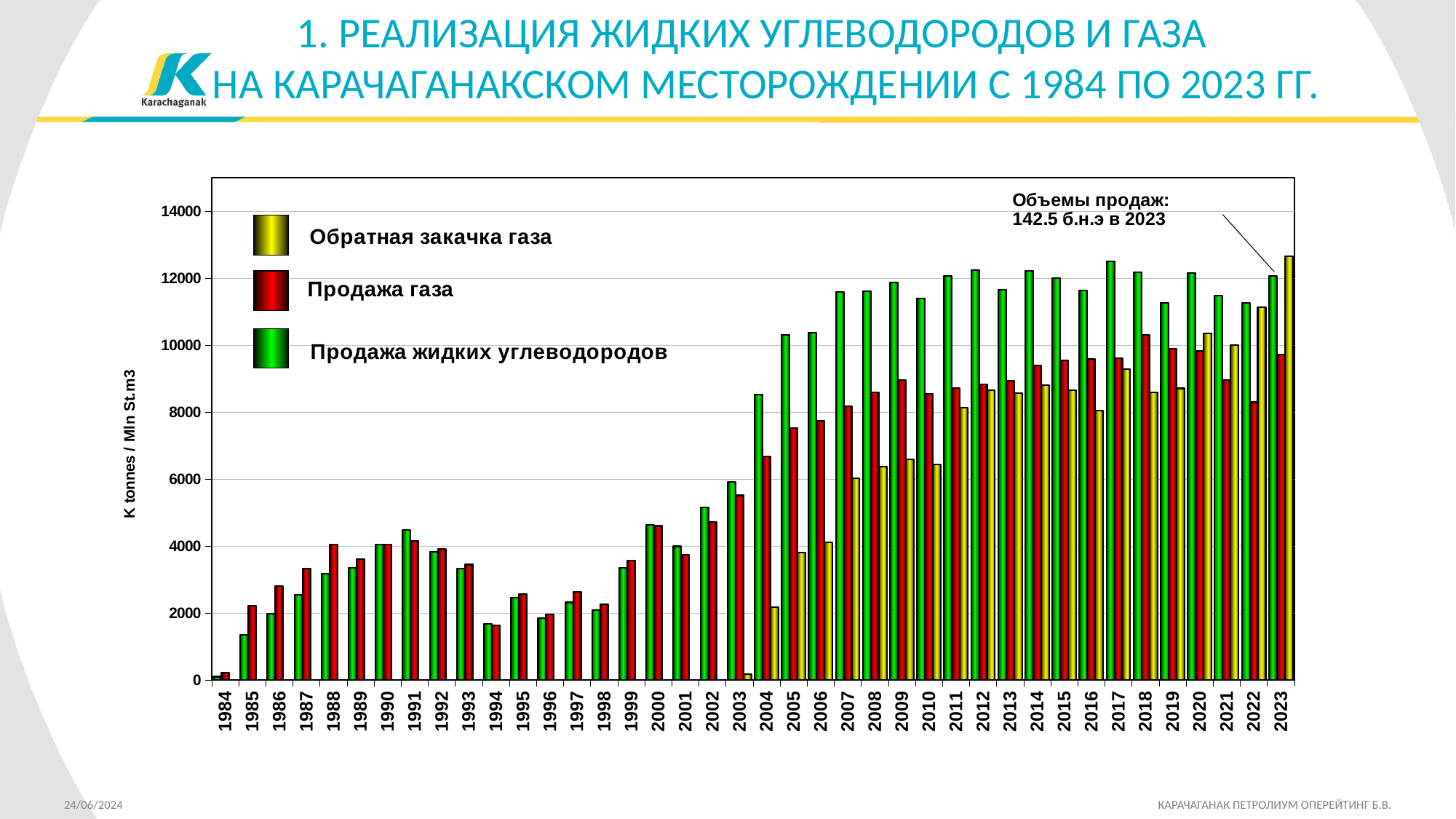
Is the value for Продажа жидких углеводородов in 1984 greater or less than 2000? less Is the value for Продажа жидких углеводородов in 2007 greater or less than 10000? greater How many series does the legend list? 3 In 1985, which is larger: Продажа газа or Продажа жидких углеводородов? Продажа газа Is the value for Обратная закачка газа in 2023 greater or less than 12000? greater What kind of chart is shown on the slide? bar chart How many years are shown on the x axis of the chart? 40 Which series is shown in yellow in the legend? Обратная закачка газа In 2006, which is larger: Продажа жидких углеводородов or Обратная закачка газа? Продажа жидких углеводородов What is the label of the vertical axis? K tonnes / Mln St.m3 In which year is the value for Обратная закачка газа the highest? 2023